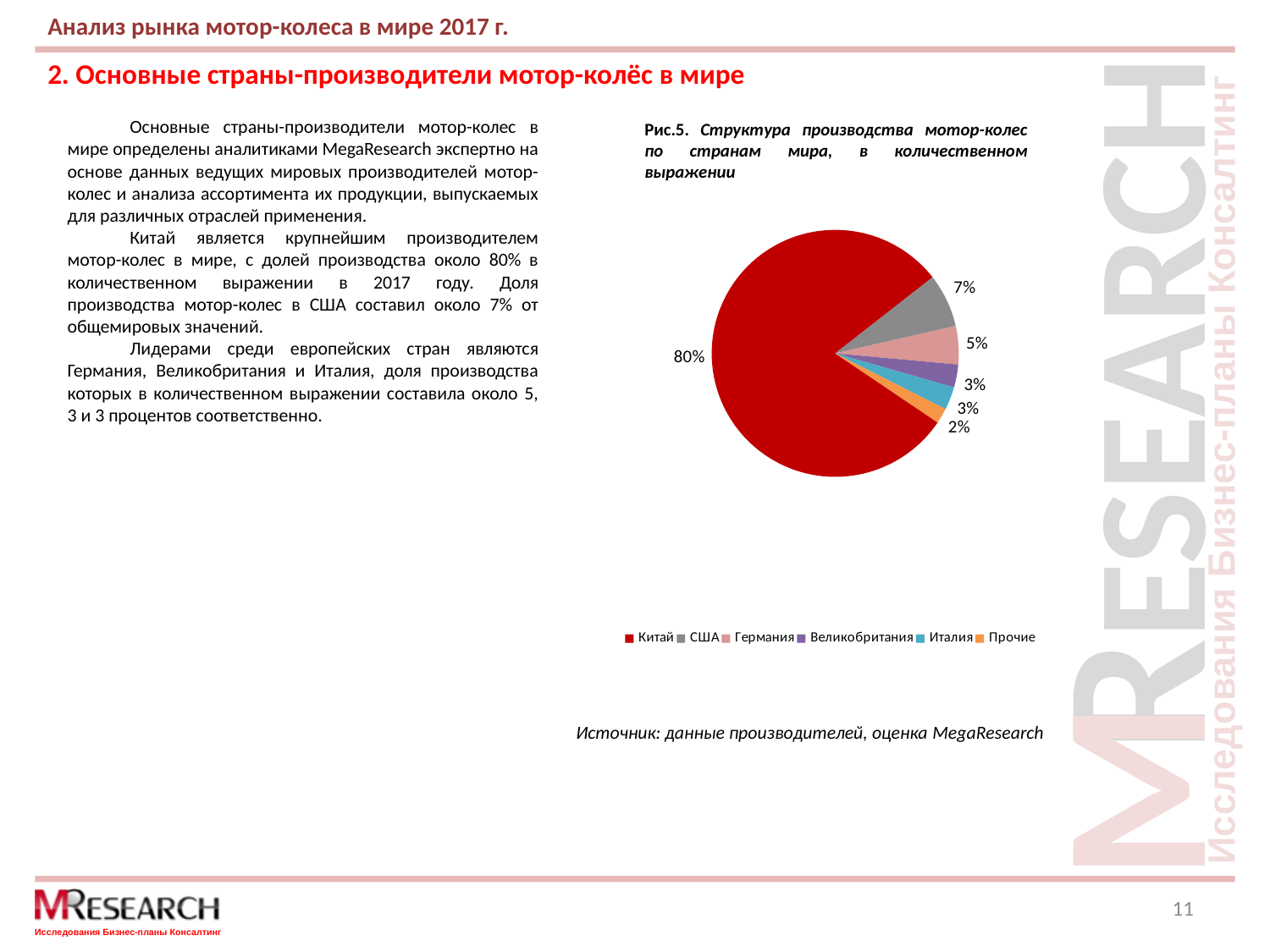
What colour is the slice for Китай in the pie chart? red What kind of chart is shown on the slide? pie chart Which has a larger share, США or Германия? США How many slices does the pie chart have? 6 What share of motor-wheel production does Китай (China) hold in the pie chart? 80% What share does Германия (Germany) hold in the pie chart? 5% What is the difference between the shares of Китай and США? 73% Which category has the smallest slice in the pie chart? Прочие Which country has the largest slice in the pie chart? Китай How many entries does the legend of the pie chart list? 6 What share does США (USA) hold in the pie chart? 7% What share does Прочие (Others) hold in the pie chart? 2%